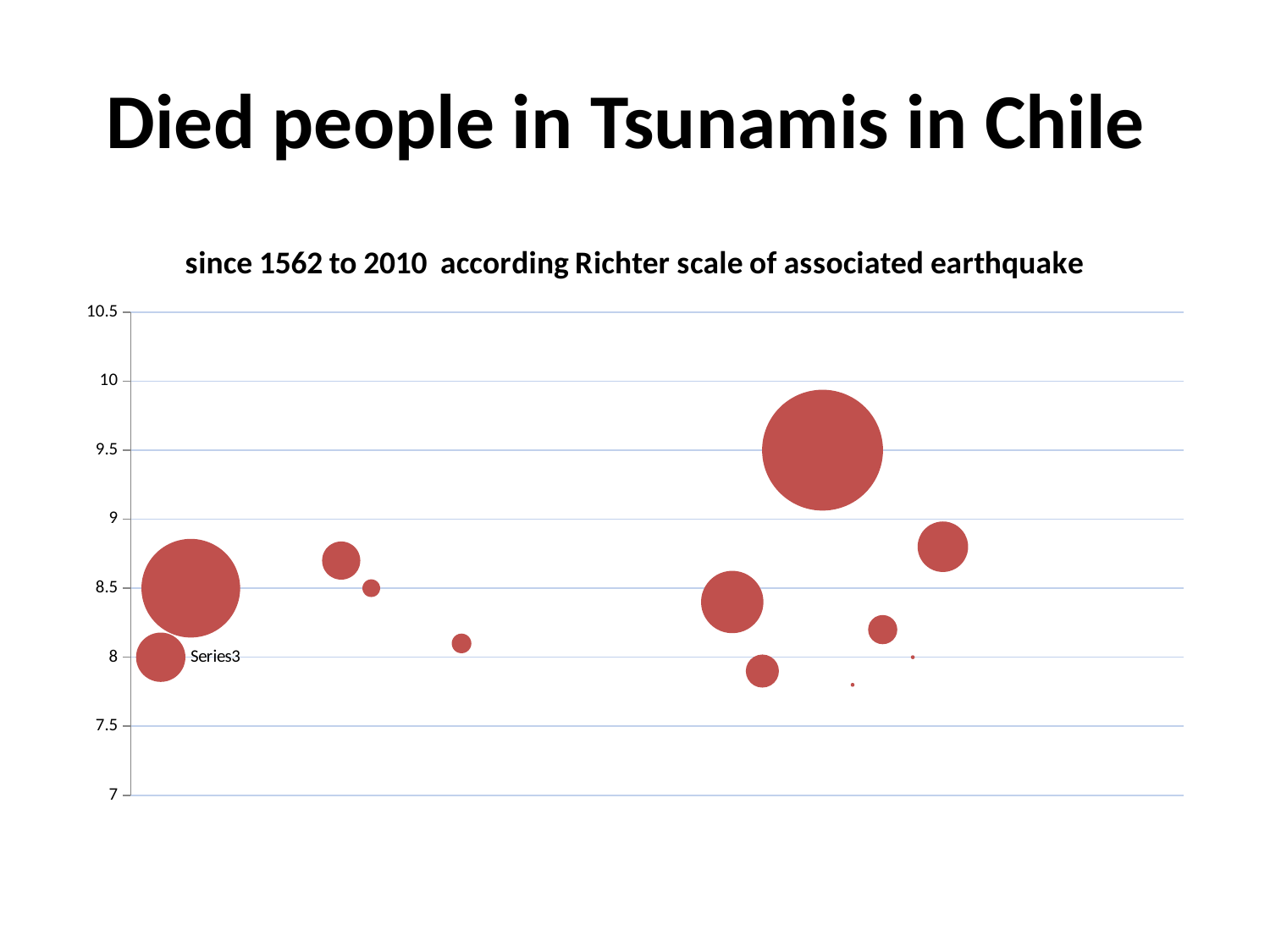
What is the highest value shown on the y axis? 10.5 What kind of chart is shown on the slide? bubble chart Is the y-axis value of the bubble labelled Series3 greater or less than 8.5? less What is the title of the chart? since 1562 to 2010 according Richter scale of associated earthquake What colour are the bubbles in the chart? red Is the y-axis value of the largest bubble greater or less than 9? greater How many tick labels are shown on the y axis? 8 At what y-axis value is the largest bubble centred? 9.5 What is the lowest value shown on the y axis? 7 Which bubble sits higher on the y axis, the largest bubble or the bubble labelled Series3? the largest bubble What is the y-axis value of the bubble labelled Series3? 8